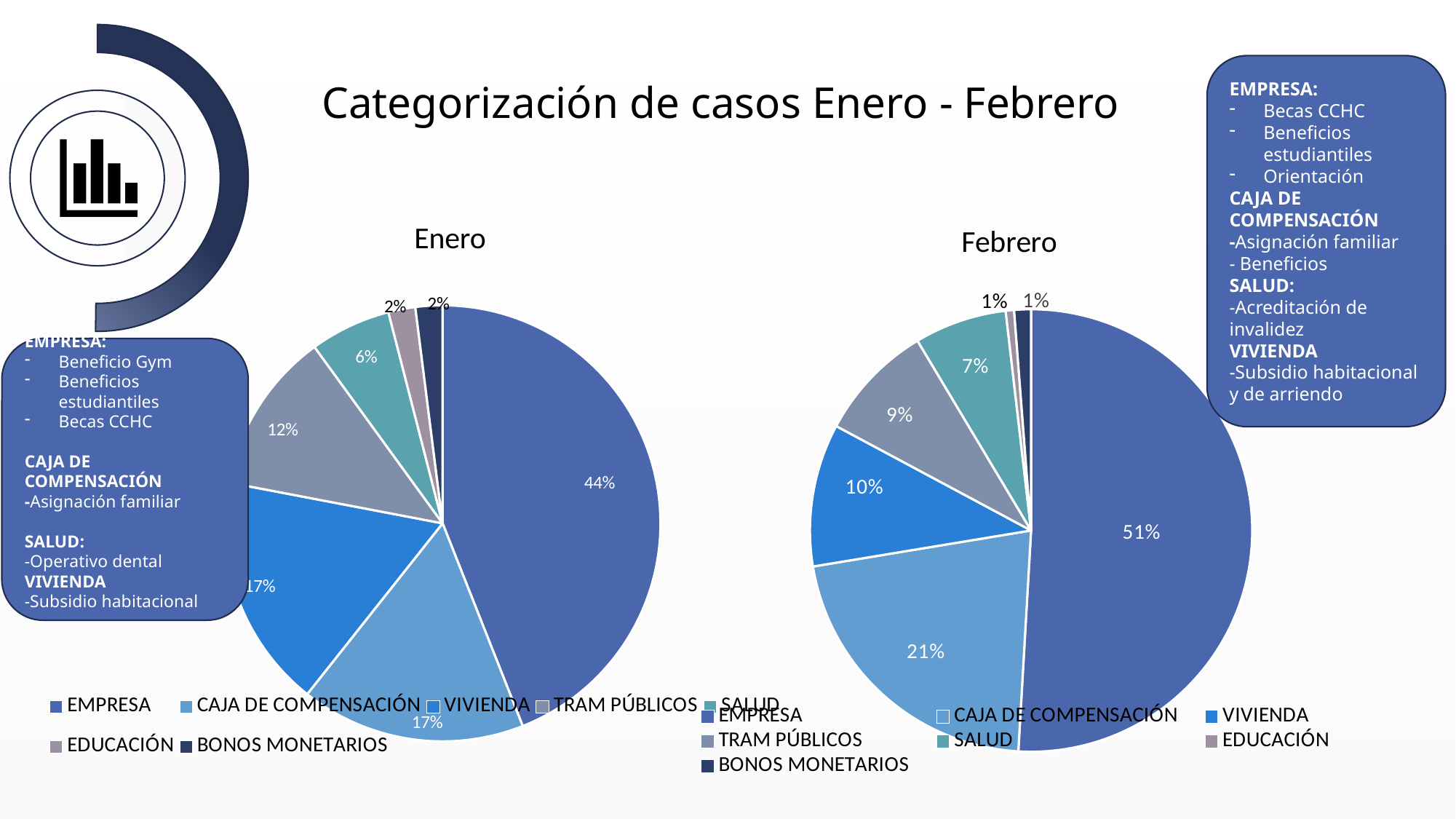
In the Febrero pie chart, what share does SALUD have? 7% How many categories does the Enero pie chart show? 7 In the Enero pie chart, what share does EMPRESA have? 44% In the Febrero pie chart, which category has the largest slice? EMPRESA What type of chart is used for Enero and Febrero? Pie chart In the Febrero pie chart, what share does CAJA DE COMPENSACIÓN have? 21% In the Febrero pie chart, which is larger, VIVIENDA or TRAM PÚBLICOS? VIVIENDA In the Enero pie chart, which category has the smallest slice, EDUCACIÓN or SALUD? EDUCACIÓN In the Enero pie chart, what share does TRAM PÚBLICOS have? 12% In the Enero pie chart, what is the combined share of CAJA DE COMPENSACIÓN and VIVIENDA? 34% What is the title of the slide? Categorización de casos Enero - Febrero What is the difference between the EMPRESA share in Febrero and the EMPRESA share in Enero? 7%